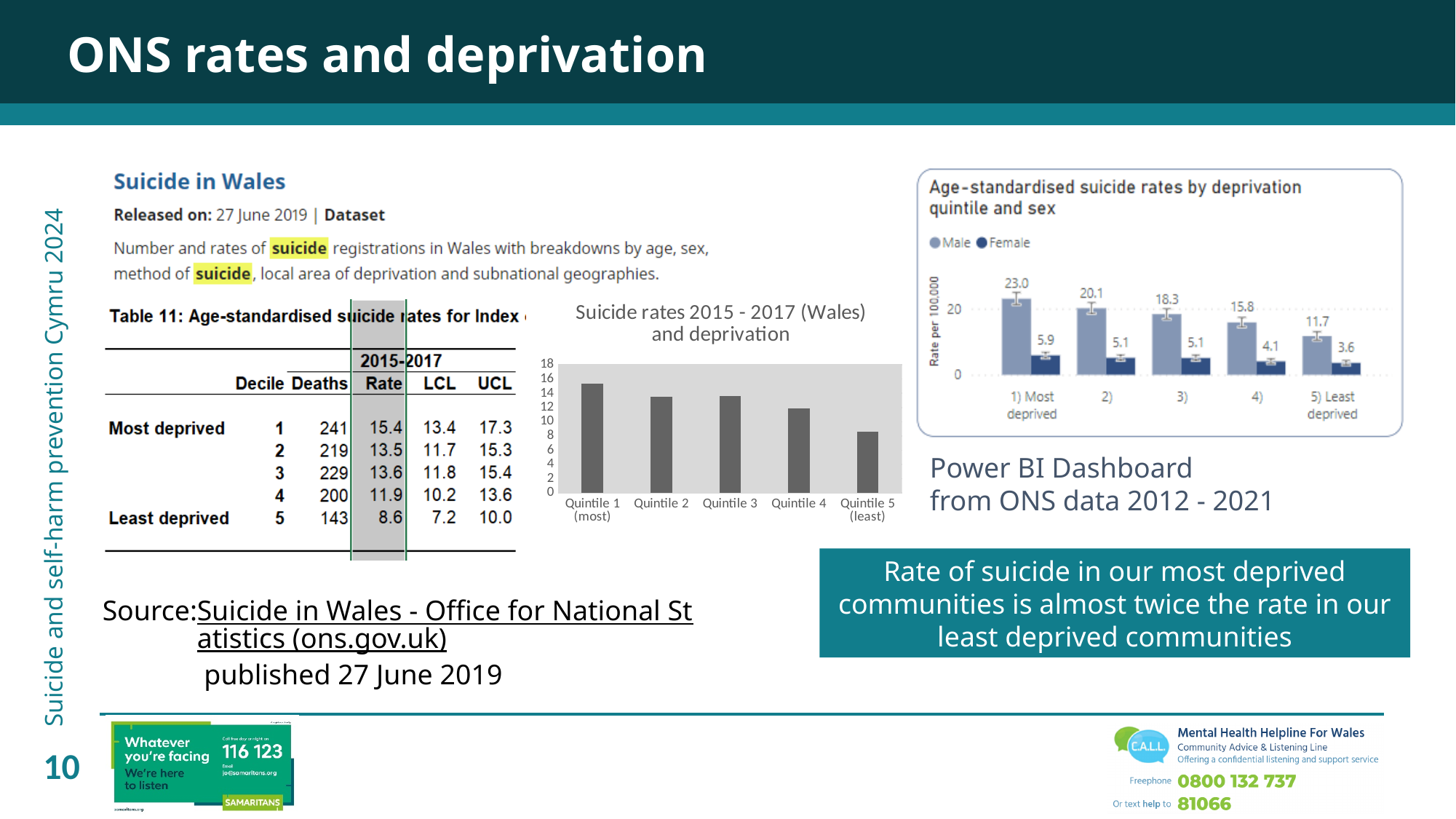
In the chart titled 'Age-standardised suicide rates by deprivation quintile and sex', which quintile has the lowest Male rate? 5) Least deprived In the chart titled 'Age-standardised suicide rates by deprivation quintile and sex', what is the Female rate for '5) Least deprived'? 3.6 In the chart titled 'Suicide rates 2015 - 2017 (Wales) and deprivation', which quintile has the highest bar? Quintile 1 (most) What kind of chart is the one titled 'Suicide rates 2015 - 2017 (Wales) and deprivation'? bar chart In the chart titled 'Age-standardised suicide rates by deprivation quintile and sex', what is the difference between the Male rates for '1) Most deprived' and '5) Least deprived'? 11.3 In the chart titled 'Age-standardised suicide rates by deprivation quintile and sex', is the Female rate for quintile 2 larger or smaller than the Female rate for quintile 4? larger In the chart titled 'Age-standardised suicide rates by deprivation quintile and sex', what is the Male rate for '1) Most deprived'? 23.0 In the chart titled 'Suicide rates 2015 - 2017 (Wales) and deprivation', how many quintiles are shown on the x axis? 5 In the chart titled 'Suicide rates 2015 - 2017 (Wales) and deprivation', is the value for Quintile 5 (least) greater or less than 10? less In the chart titled 'Age-standardised suicide rates by deprivation quintile and sex', do the Male rates rise or fall from most deprived to least deprived? fall In the chart titled 'Age-standardised suicide rates by deprivation quintile and sex', what is the Male rate for quintile 3? 18.3 In the chart titled 'Age-standardised suicide rates by deprivation quintile and sex', how many series does the legend list? 2